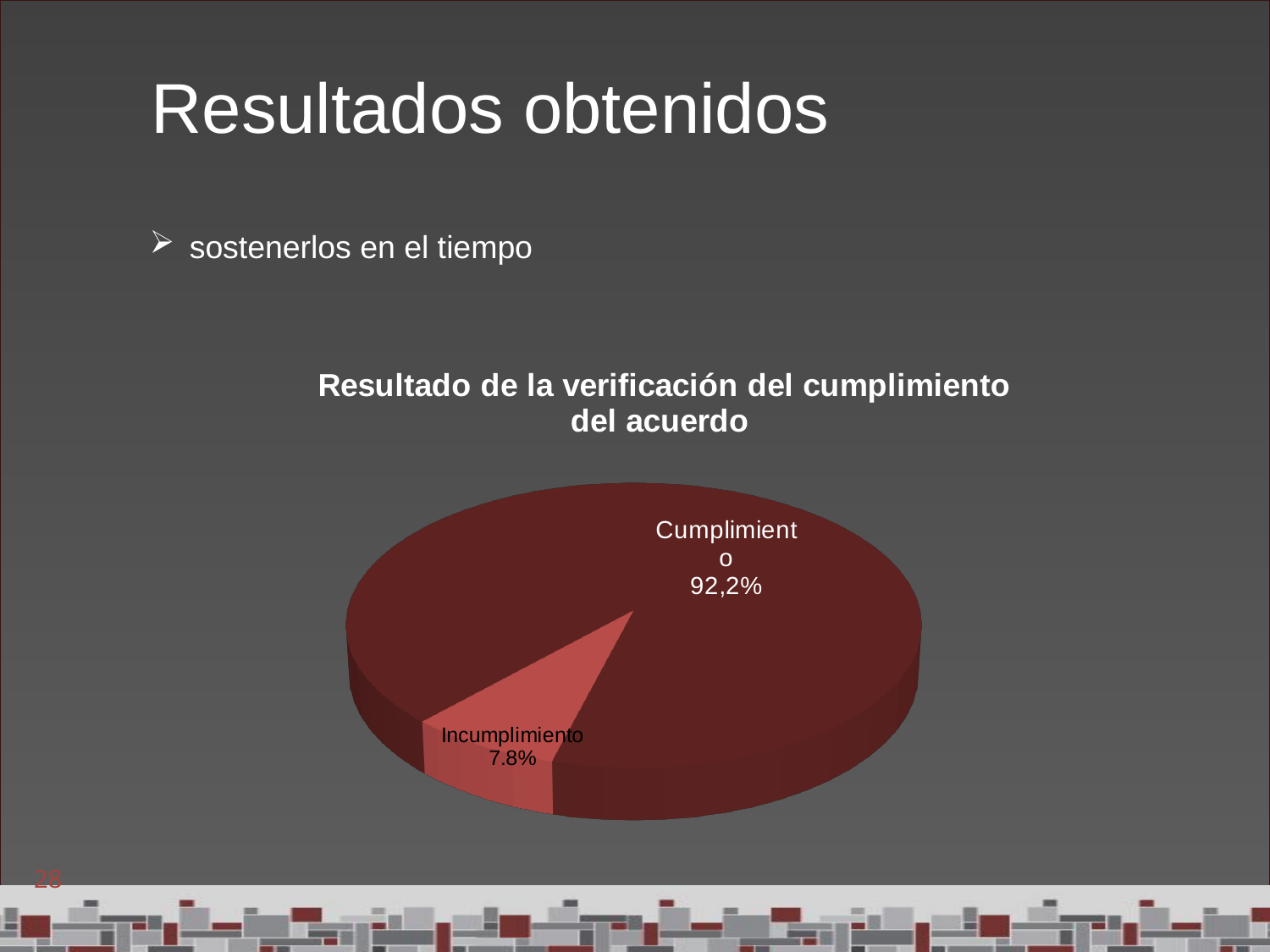
What kind of chart is shown on the slide? pie chart What is the title of the chart? Resultado de la verificación del cumplimiento del acuerdo Which is larger, the Cumplimiento slice or the Incumplimiento slice? Cumplimiento What share of the pie is labelled Cumplimiento? 92,2% Which slice of the pie is the smallest? Incumplimiento What share of the pie is labelled Incumplimiento? 7.8% Is the share for Cumplimiento greater or less than 50%? greater Which slice of the pie is the largest? Cumplimiento How many slices does the pie chart have? 2 Is the share for Incumplimiento greater or less than 10%? less What colour is the Incumplimiento slice compared with the Cumplimiento slice? lighter red